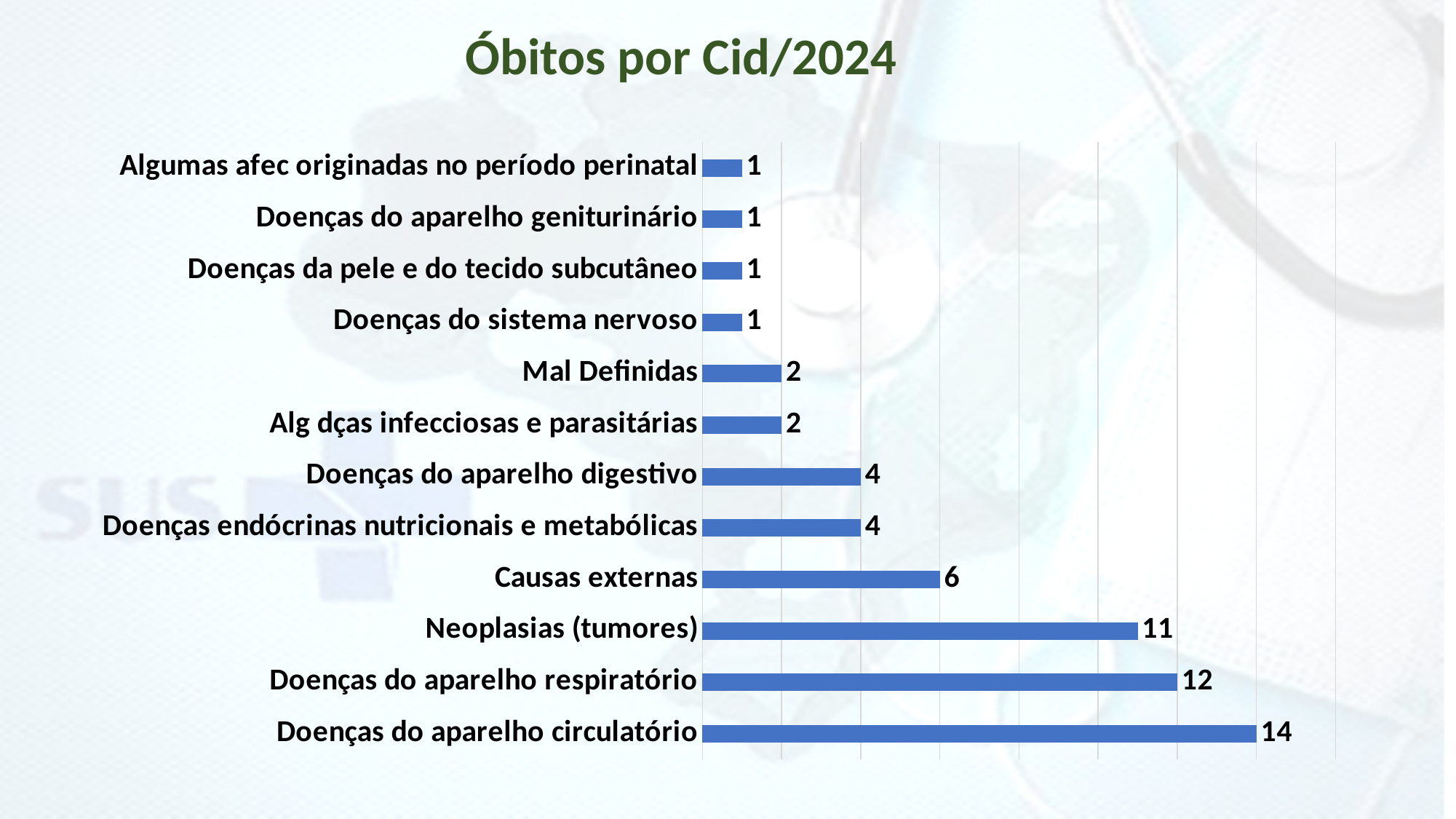
How many categories are shown in the chart? 12 What is the value for Neoplasias (tumores)? 11 Which is larger, Doenças do aparelho respiratório or Neoplasias (tumores)? Doenças do aparelho respiratório What is the value for Mal Definidas? 2 What is the value for Doenças do aparelho circulatório? 14 What is the difference between Neoplasias (tumores) and Causas externas? 5 What is the value for Causas externas? 6 Which category has the highest value? Doenças do aparelho circulatório What is the title of the chart? Óbitos por Cid/2024 What kind of chart is shown on the slide? Bar chart Which is larger, Causas externas or Doenças do aparelho digestivo? Causas externas What is the difference between Doenças do aparelho circulatório and Doenças do aparelho respiratório? 2